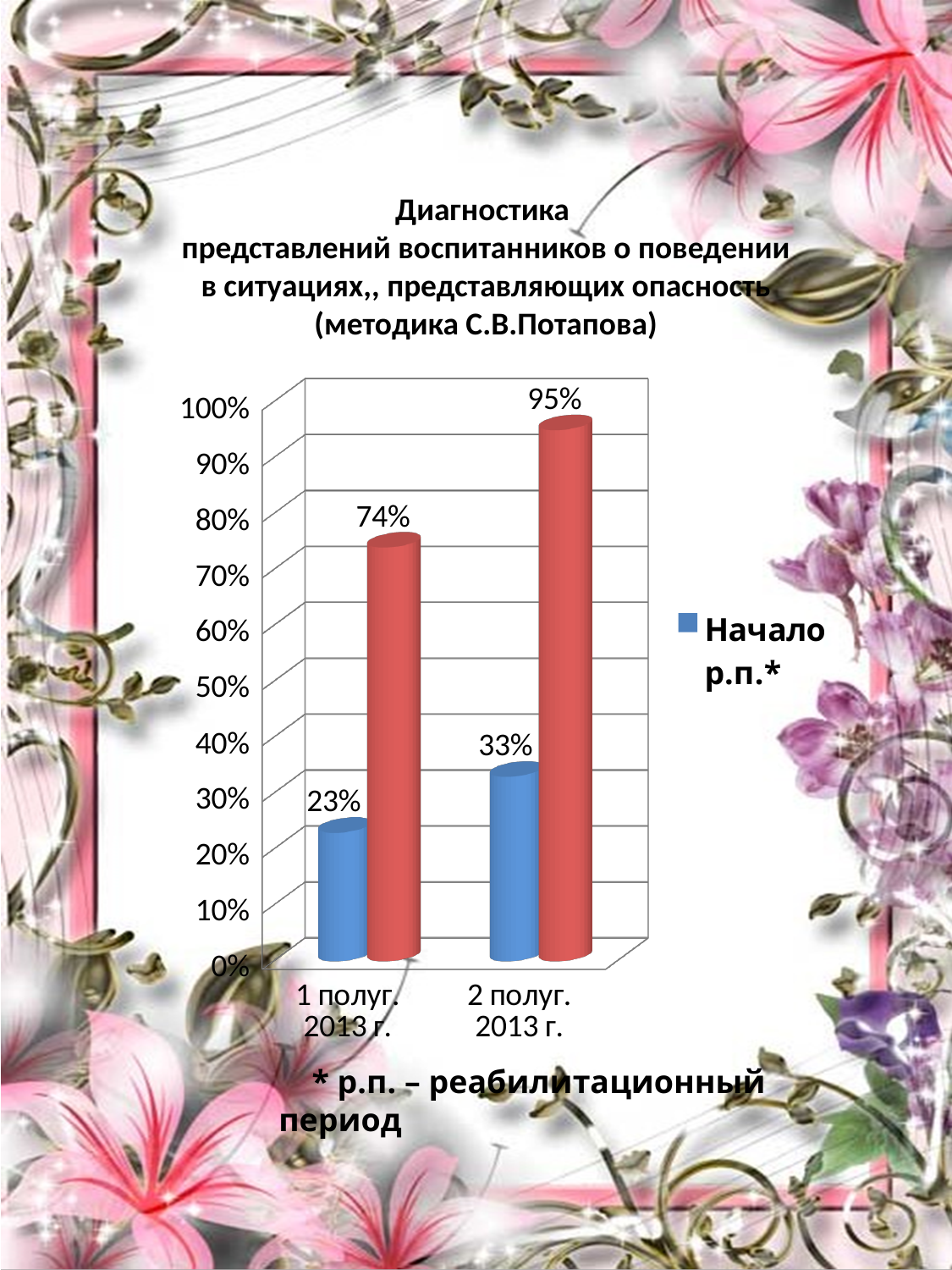
What is the difference between the red and blue bar values for 1 полуг. 2013 г.? 51% Which is larger: the blue bar for 2 полуг. 2013 г. or the red bar for 1 полуг. 2013 г.? the red bar for 1 полуг. 2013 г. What is the difference between the red bar values for 2 полуг. 2013 г. and 1 полуг. 2013 г.? 21% What type of chart is shown on the slide? bar chart Which category has the lowest blue bar (Начало р.п.*) value? 1 полуг. 2013 г. What is the legend entry shown next to the blue marker? Начало р.п.* What is the value of the red bar for 1 полуг. 2013 г.? 74% How many categories are shown on the x axis? 2 What is the value of the red bar for 2 полуг. 2013 г.? 95% Which category has the highest red bar value? 2 полуг. 2013 г. What is the value of the blue bar (Начало р.п.*) for 1 полуг. 2013 г.? 23% What is the value of the blue bar (Начало р.п.*) for 2 полуг. 2013 г.? 33%